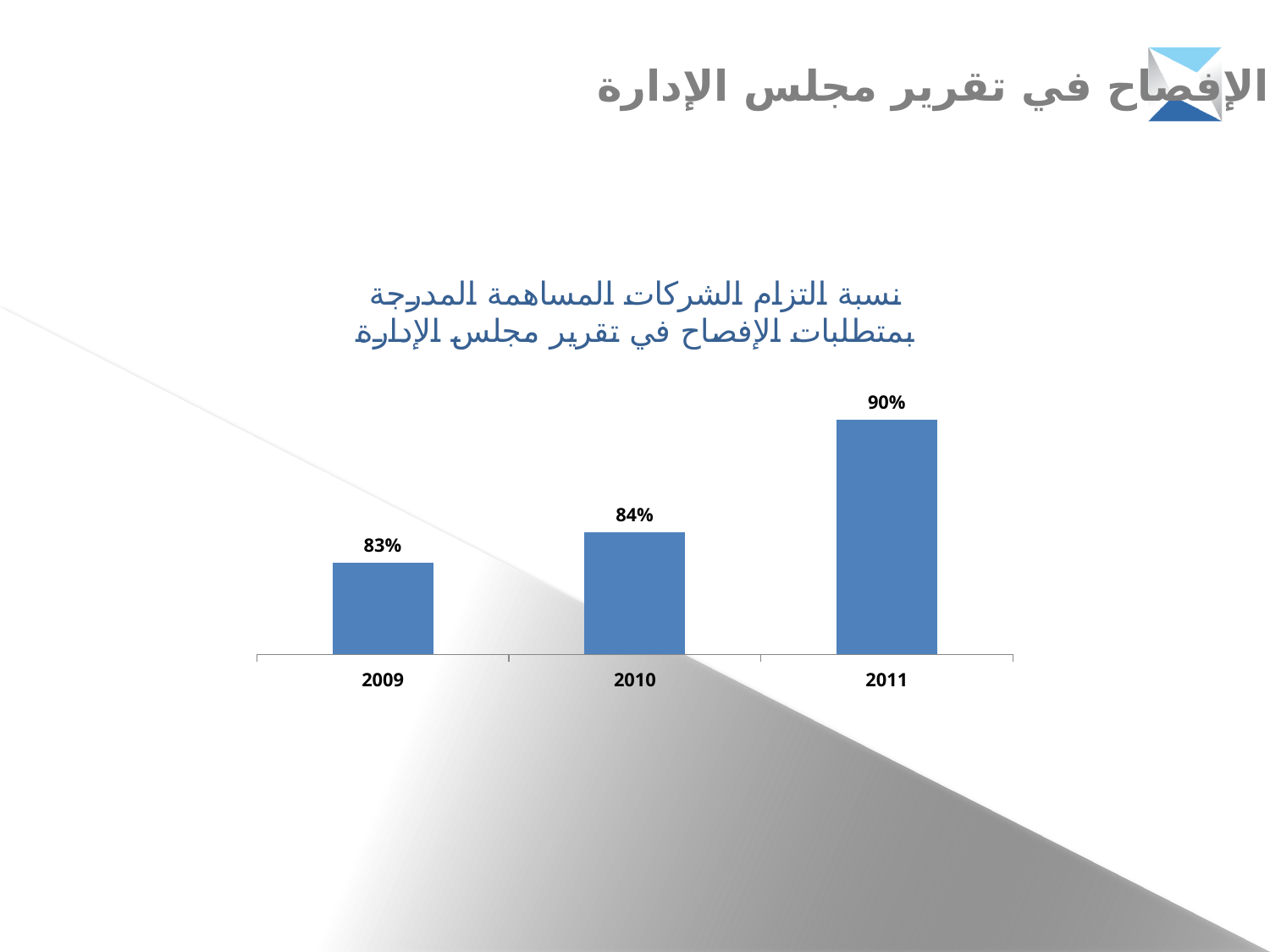
What is the value for 2011? 90% What is the value for 2009? 83% Which year has the lowest value? 2009 How many years are shown on the x axis? 3 What colour are the bars in the chart? Blue Which year has the highest value? 2011 What is the value for 2010? 84% Do the values rise or fall from 2009 to 2011? Rise What is the difference between the values for 2011 and 2010? 6% What is the difference between the values for 2011 and 2009? 7% Which is larger, the value for 2010 or the value for 2011? 2011 What kind of chart is shown on the slide? Bar chart